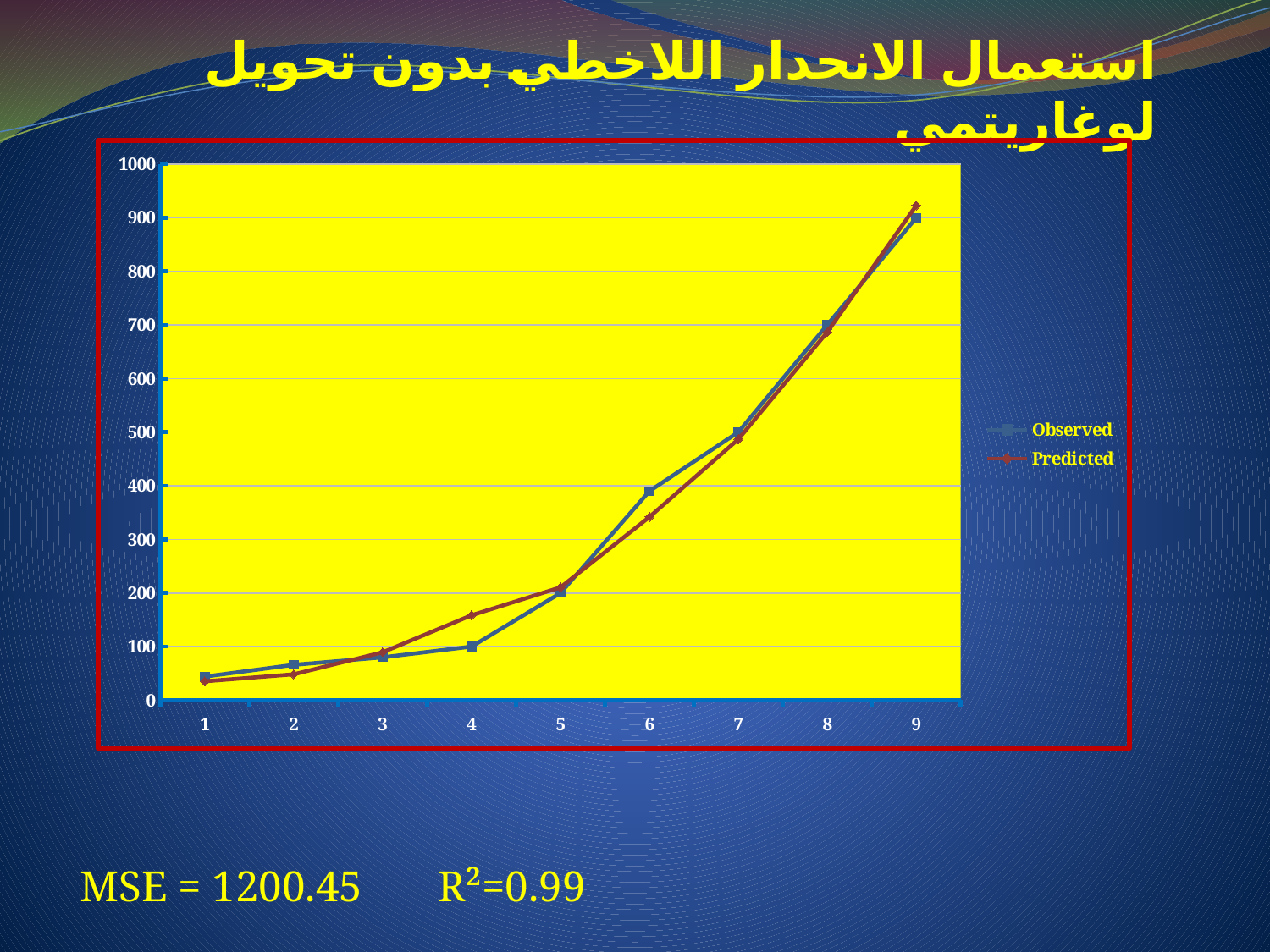
At x = 4, which series has the larger value, Observed or Predicted? Predicted Do the Observed values rise or fall as x increases from 1 to 9? rise Is the Observed value at x = 6 greater or less than 300? greater Is the Predicted value at x = 9 greater or less than 900? greater How many points are plotted along the x axis for each series? 9 Is the Observed value at x = 3 greater or less than 100? less At which x value is the Observed series highest? 9 At x = 6, which series has the larger value, Observed or Predicted? Observed What are the two series named in the legend? Observed and Predicted How many series does the legend list? 2 What kind of chart is shown on the slide? line chart At which x value is the Predicted series lowest? 1